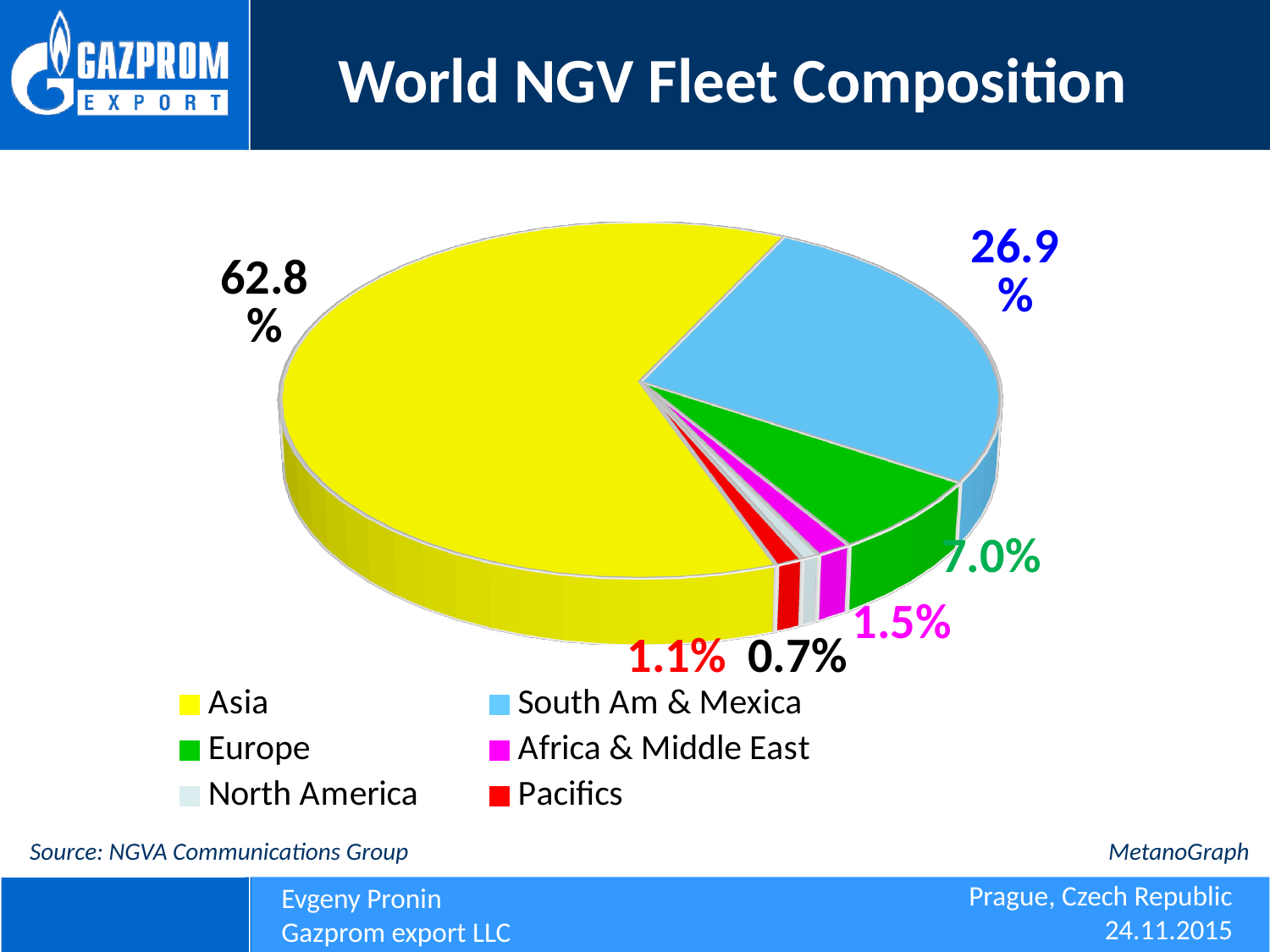
What is the title of the chart? World NGV Fleet Composition Which region has the smallest share of the world NGV fleet? North America What is the value shown for South Am & Mexica? 26.9% What share of the world NGV fleet does Asia account for? 62.8% Which has a larger share, Europe or Africa & Middle East? Europe What is the value shown for Africa & Middle East? 1.5% How many regions are shown in the pie chart? 6 What is the value shown for Pacifics? 1.1% What kind of chart is shown on the slide? pie chart Which region has the largest share of the world NGV fleet? Asia What is the difference between the shares of Asia and South Am & Mexica? 35.9% What is the value shown for Europe? 7.0%